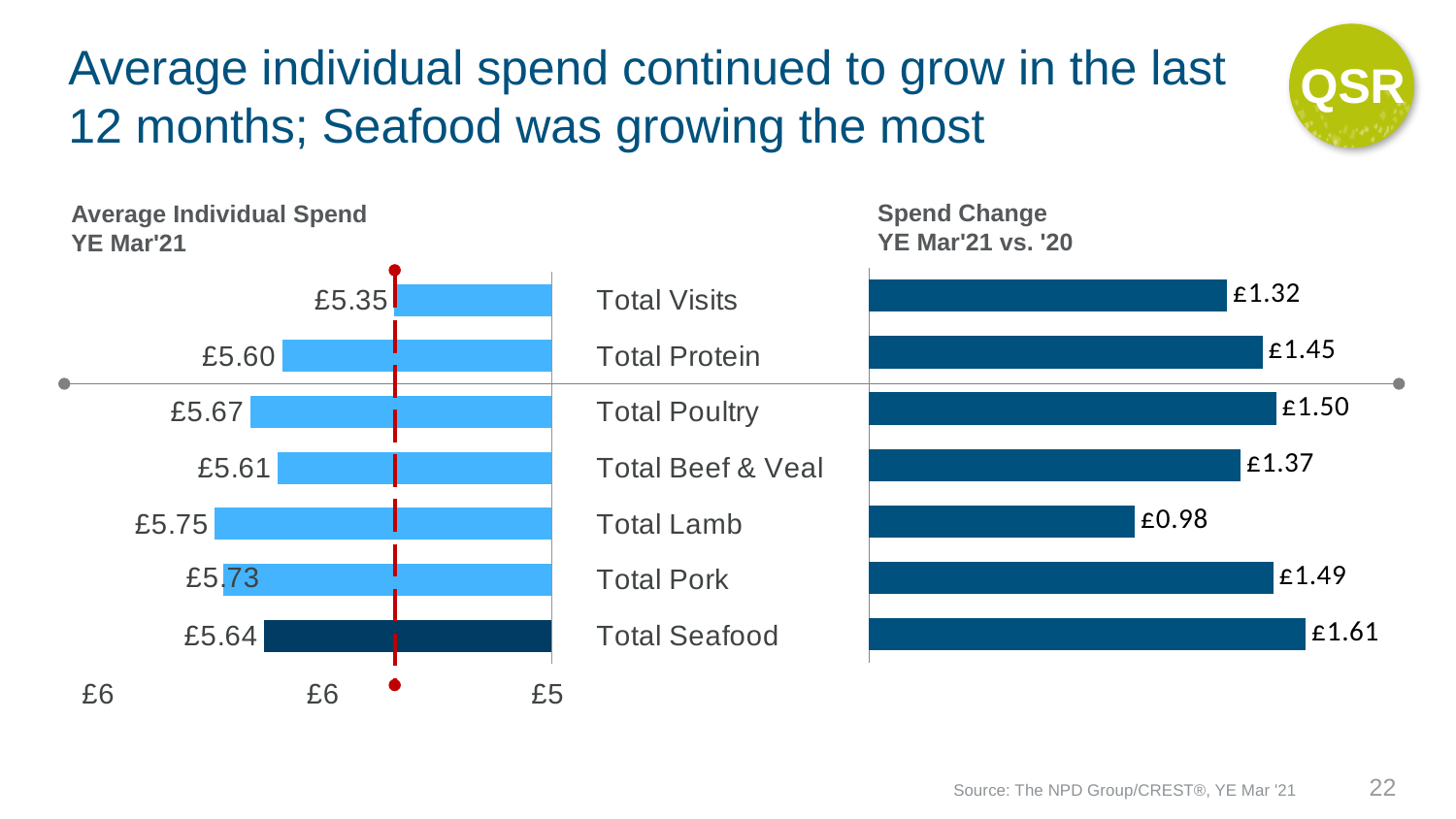
In the Spend Change chart, which category has the lowest value? Total Lamb In the Spend Change chart, what is the value for Total Lamb? £0.98 In the Spend Change chart, which category has the highest value? Total Seafood How many categories are shown in the Spend Change chart? 7 In the Average Individual Spend chart, which category has the lowest value? Total Visits In the Spend Change chart, what is the difference between Total Seafood and Total Lamb? £0.63 In the Average Individual Spend chart, what is the value for Total Visits? £5.35 What type of chart is the Spend Change chart? Bar chart In the Average Individual Spend chart, what is the difference between Total Lamb and Total Visits? £0.40 In the Spend Change chart, which is larger, Total Poultry or Total Beef & Veal? Total Poultry In the Spend Change chart, what is the value for Total Seafood? £1.61 In the Average Individual Spend chart, what is the value for Total Lamb? £5.75